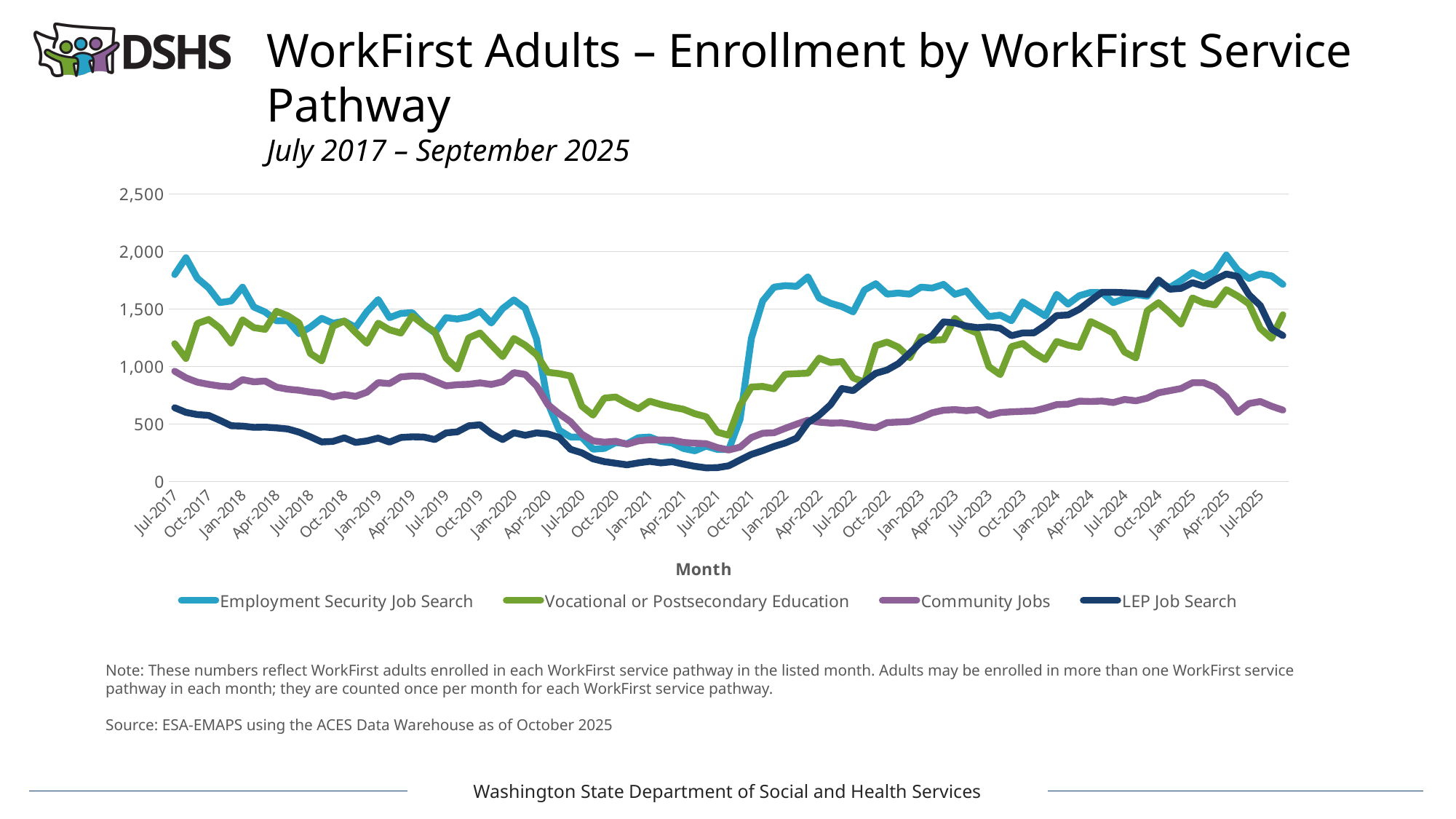
Is the value for Vocational or Postsecondary Education in Oct-2020 greater or less than 1,000? less In Apr-2025, which is larger: LEP Job Search or Community Jobs? LEP Job Search What is the title of the x axis? Month Which series has the lowest value in Jul-2017? LEP Job Search What kind of chart is shown on the slide? line chart Which series is plotted with the dark navy line? LEP Job Search Is the value for Community Jobs in Jan-2025 greater or less than 1,000? less Which series has the highest value in Jul-2017? Employment Security Job Search Is the value for Employment Security Job Search in Jul-2017 greater or less than 1,500? greater How many series does the legend list? 4 Does the LEP Job Search line rise or fall between Jul-2021 and Apr-2025? rise